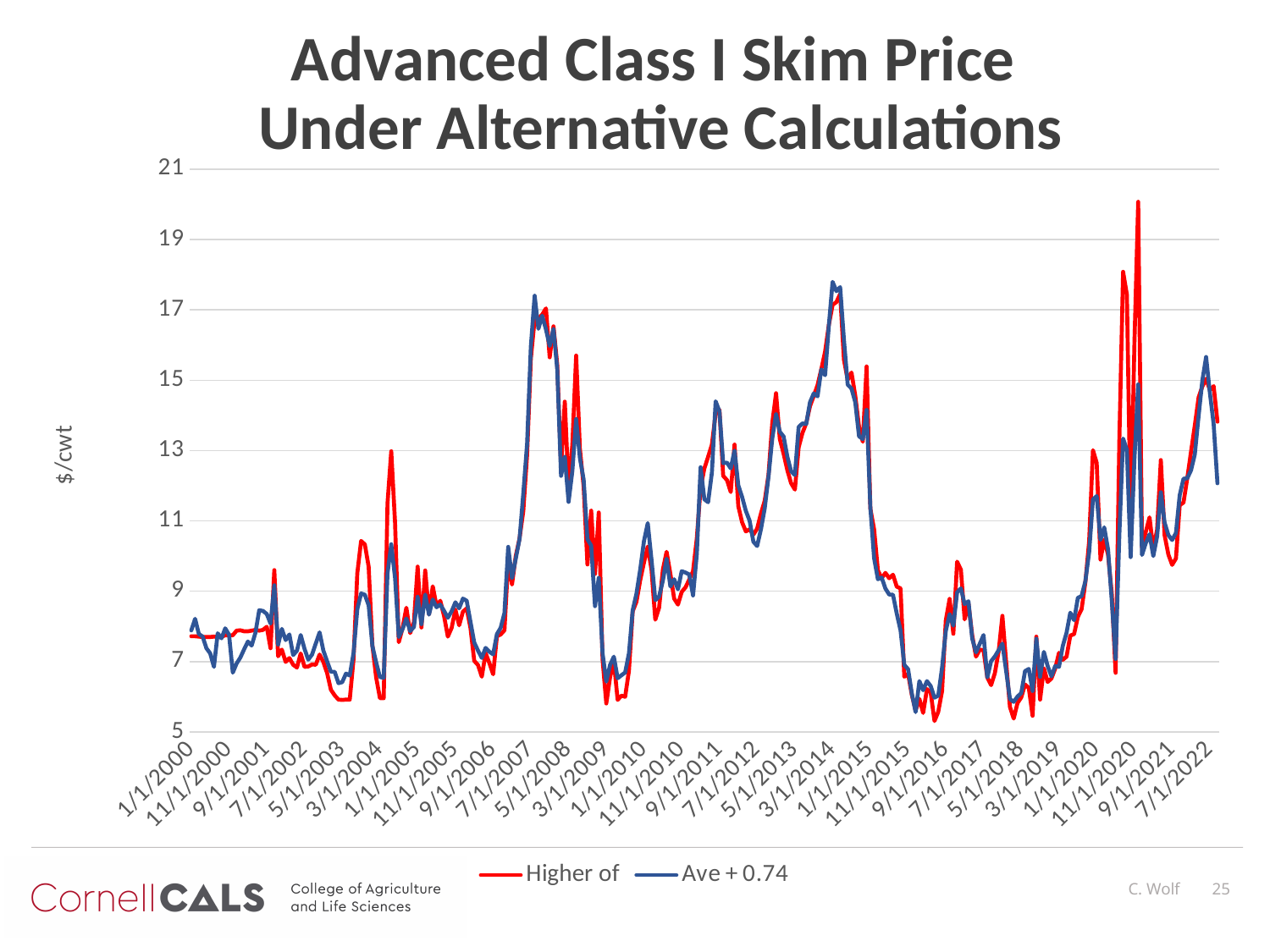
Is the value of the Higher of series at 1/1/2000 greater or less than 9? less Which series reaches the highest value anywhere on the chart? Higher of What is the label on the vertical axis? $/cwt What is the highest value shown on the vertical axis? 21 What is the title of the chart? Advanced Class I Skim Price Under Alternative Calculations Between 1/1/2015 and 9/1/2016, do the values generally rise or fall? fall Is the highest value reached by the Ave + 0.74 series around 2014 greater or less than 15? greater What kind of chart is shown on the slide? Line chart Between 9/1/2006 and 7/1/2007, do the values generally rise or fall? rise Is the peak value of the Higher of series around 2020 greater or less than 19? greater How many series does the legend list? 2